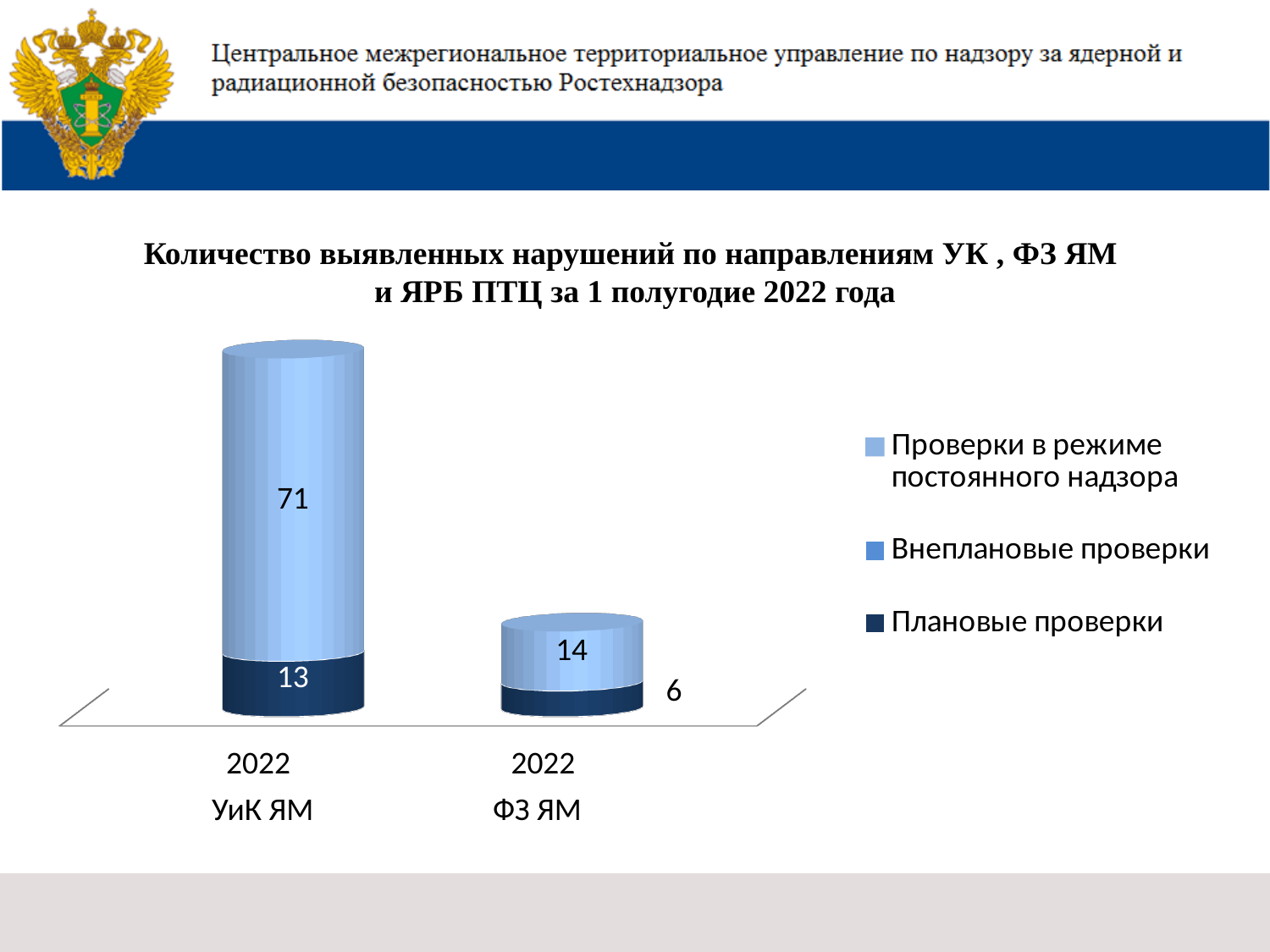
How many series does the legend list? 3 What is the value of Плановые проверки for ФЗ ЯМ? 6 What is the difference between the Проверки в режиме постоянного надзора values for УиК ЯМ and ФЗ ЯМ? 57 What is the value of Проверки в режиме постоянного надзора for УиК ЯМ? 71 Which category has the lowest value for Плановые проверки? ФЗ ЯМ How many categories are shown on the x axis of the chart? 2 Which category has the higher value for Проверки в режиме постоянного надзора, УиК ЯМ or ФЗ ЯМ? УиК ЯМ What type of chart is shown on the slide? Stacked bar chart What is the difference between the Плановые проверки values for УиК ЯМ and ФЗ ЯМ? 7 What is the value of Проверки в режиме постоянного надзора for ФЗ ЯМ? 14 What is the value of Плановые проверки for УиК ЯМ? 13 Which series is shown in the darkest blue colour in the legend? Плановые проверки